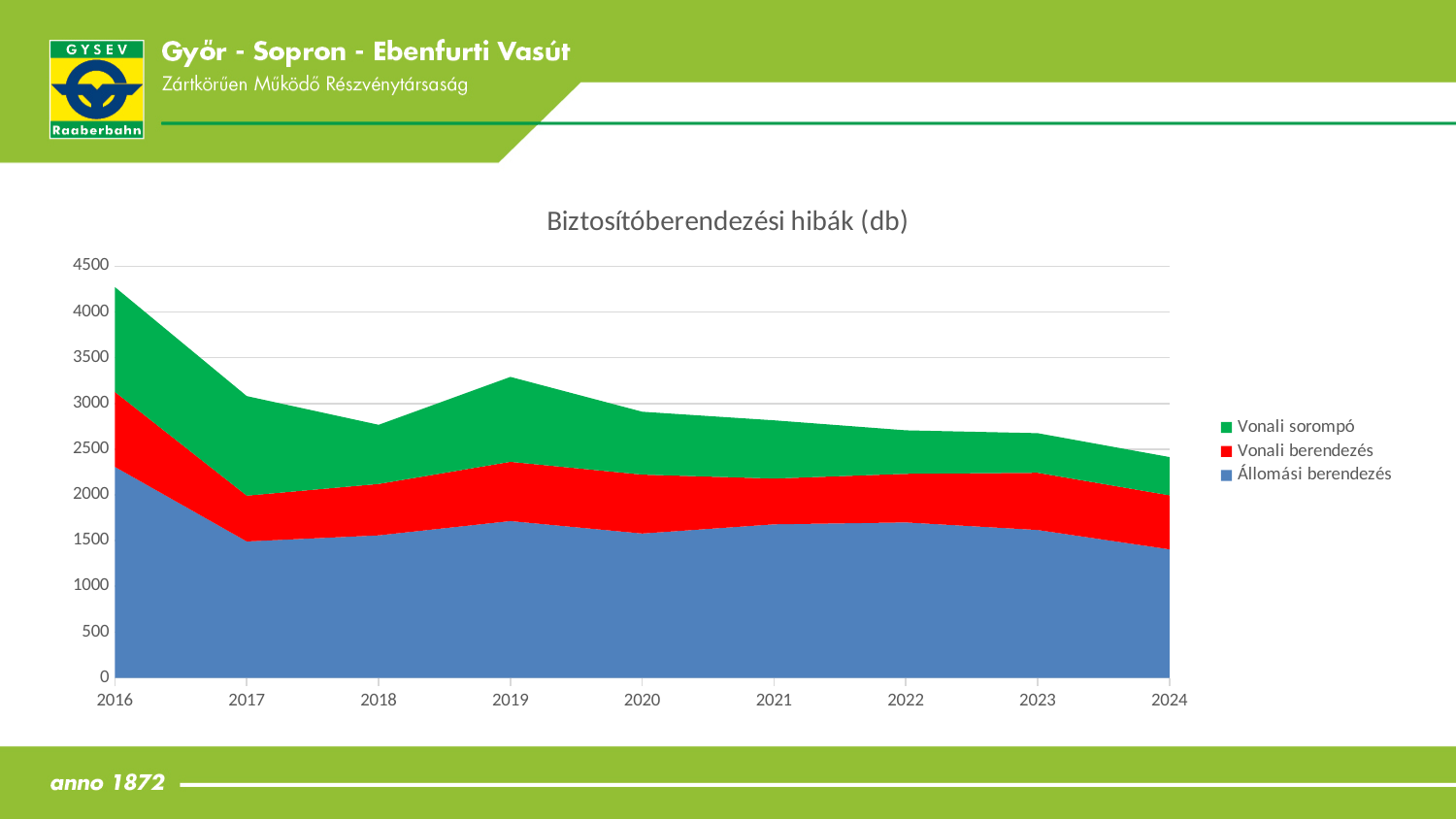
In which year is the total number of faults highest? 2016 How many years are shown along the x axis? 9 Does the total number of faults rise or fall from 2016 to 2017? fall What is the title of the chart? Biztosítóberendezési hibák (db) Is the total value for 2018 greater or less than 3000? less Is the value for Állomási berendezés in 2016 greater or less than 2000? greater What kind of chart is shown on the slide? Stacked area chart In which year is the total number of faults lowest? 2024 Is the total value for 2016 greater or less than 4000? greater How many series does the legend list? 3 Which series is shown in green? Vonali sorompó